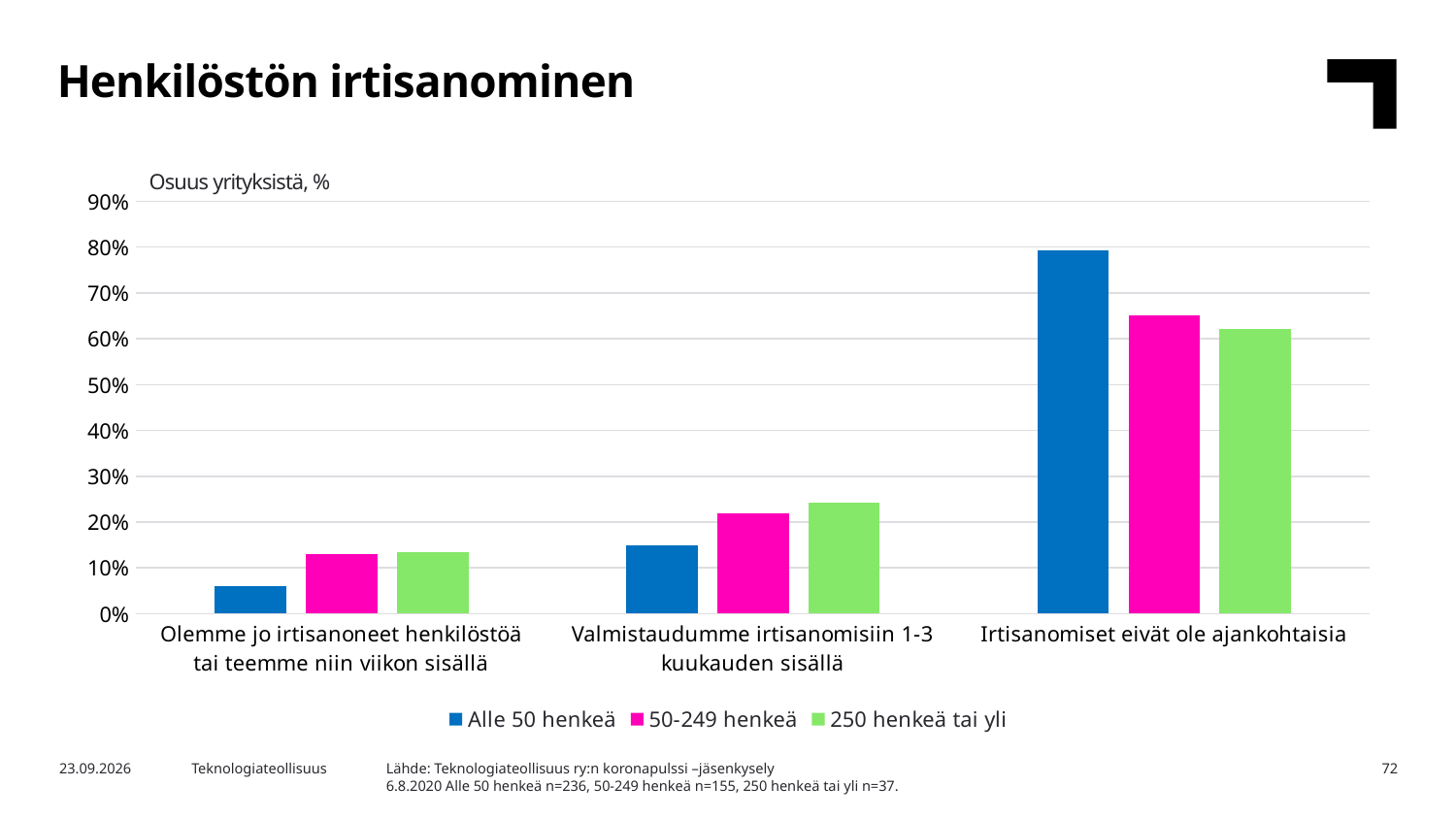
In the category 'Irtisanomiset eivät ole ajankohtaisia', which series has the larger value: 'Alle 50 henkeä' or '250 henkeä tai yli'? Alle 50 henkeä Is the value for 'Alle 50 henkeä' in the category 'Irtisanomiset eivät ole ajankohtaisia' greater or less than 70%? greater How many categories are shown on the x axis? 3 What are the three series listed in the legend? Alle 50 henkeä, 50-249 henkeä, 250 henkeä tai yli For the series 'Alle 50 henkeä', which category has the highest value? Irtisanomiset eivät ole ajankohtaisia For the series 'Alle 50 henkeä', which category has the lowest value? Olemme jo irtisanoneet henkilöstöä tai teemme niin viikon sisällä What label is shown above the vertical axis of the chart? Osuus yrityksistä, % Is the value for '250 henkeä tai yli' in the category 'Valmistaudumme irtisanomisiin 1-3 kuukauden sisällä' greater or less than 30%? less In the category 'Valmistaudumme irtisanomisiin 1-3 kuukauden sisällä', which series has the larger value: 'Alle 50 henkeä' or '250 henkeä tai yli'? 250 henkeä tai yli How many series does the legend list? 3 What kind of chart is shown on the slide? Bar chart Is the value for '50-249 henkeä' in the category 'Olemme jo irtisanoneet henkilöstöä tai teemme niin viikon sisällä' greater or less than 20%? less